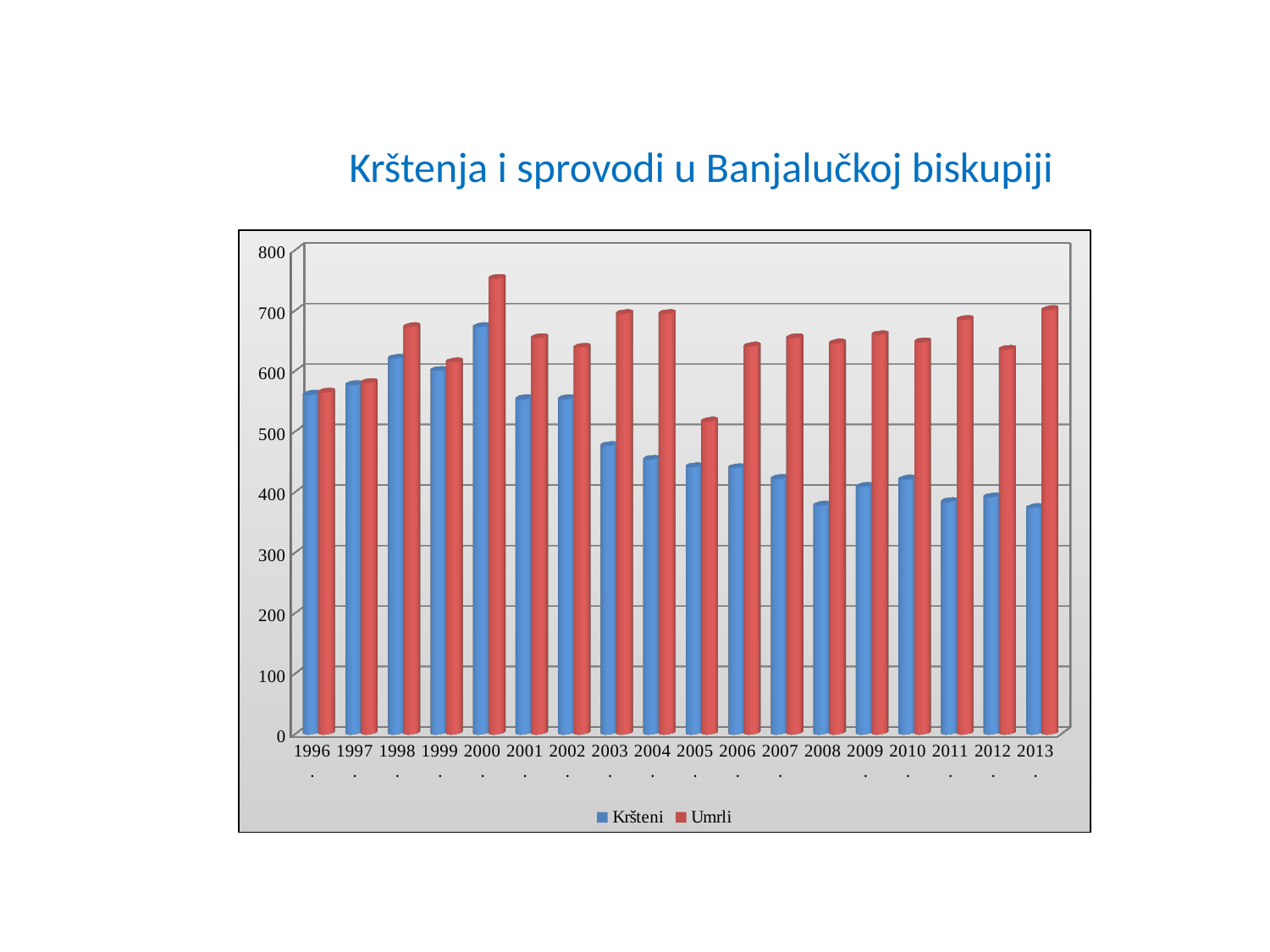
In which year is the Umrli value lowest? 2005 In 2005, which is larger, Kršteni or Umrli? Umrli Is the Kršteni value for 2013 greater or less than 400? less What kind of chart is shown on the slide? bar chart How many years are shown on the x axis? 18 How many series does the legend list? 2 In which year is the Kršteni value highest? 2000 In which year is the Umrli value highest? 2000 Is the Umrli value for 2000 greater or less than 700? greater Is the Kršteni value for 2000 greater or less than 600? greater Overall, do the Kršteni values rise or fall from 1996 to 2013? fall What is the title of the chart? Krštenja i sprovodi u Banjalučkoj biskupiji